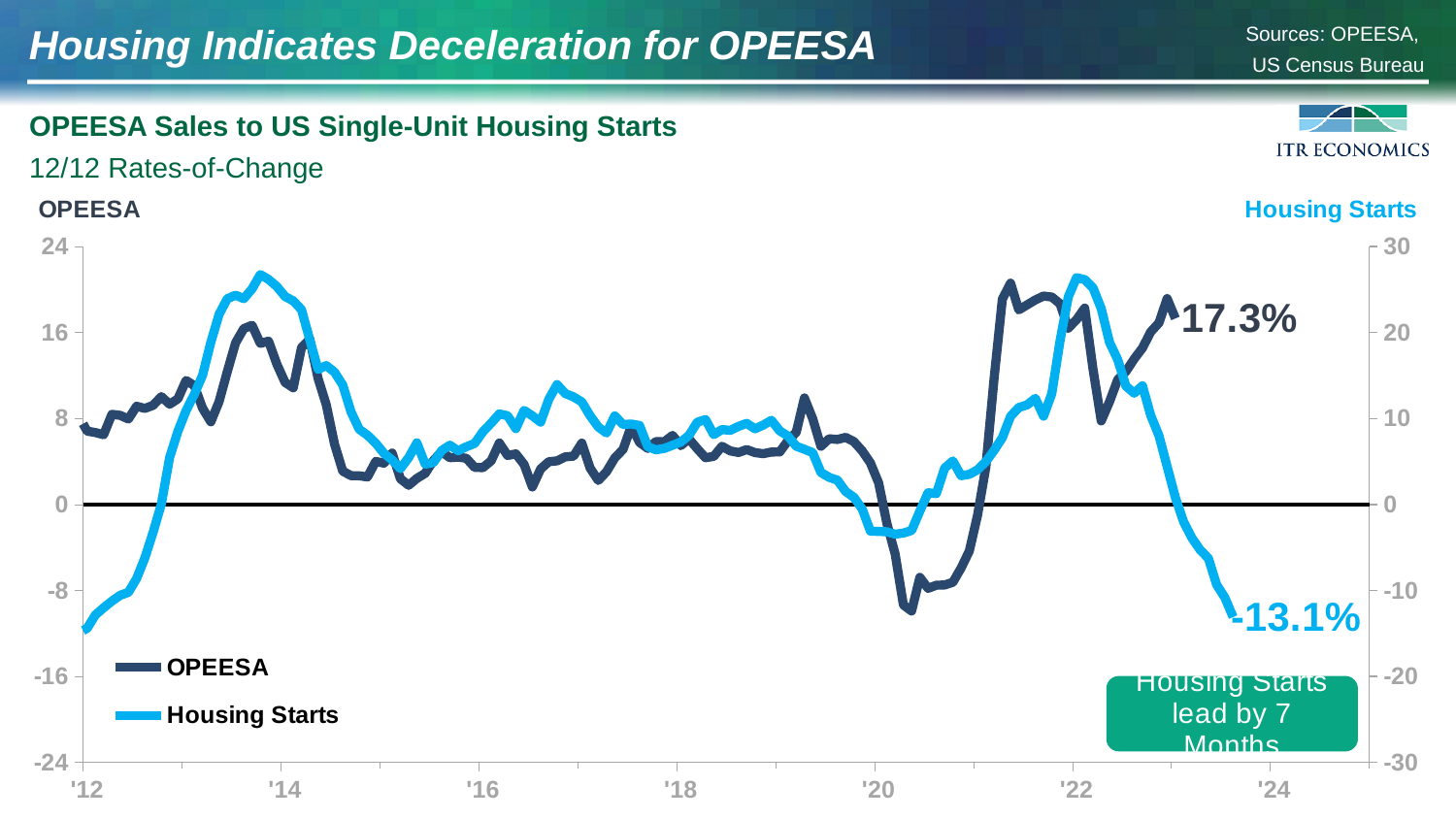
According to the annotation on the chart, by how many months do Housing Starts lead? 7 Months What is the difference between the latest labelled OPEESA value (17.3%) and the latest labelled Housing Starts value (-13.1%)? 30.4 percentage points What is the latest labelled value for the Housing Starts series? -13.1% Does the Housing Starts series rise or fall between '22 and its latest point? fall How many series does the chart's legend list? 2 What type of chart is shown on the slide? Line chart Is the latest OPEESA value greater or less than 16 on the left axis? greater How many year labels are shown on the x axis? 7 What is the latest labelled value for the OPEESA series? 17.3% What is the title of the chart? OPEESA Sales to US Single-Unit Housing Starts Which series has the higher latest labelled value, OPEESA or Housing Starts? OPEESA Is the latest Housing Starts value greater or less than -10 on the right axis? less